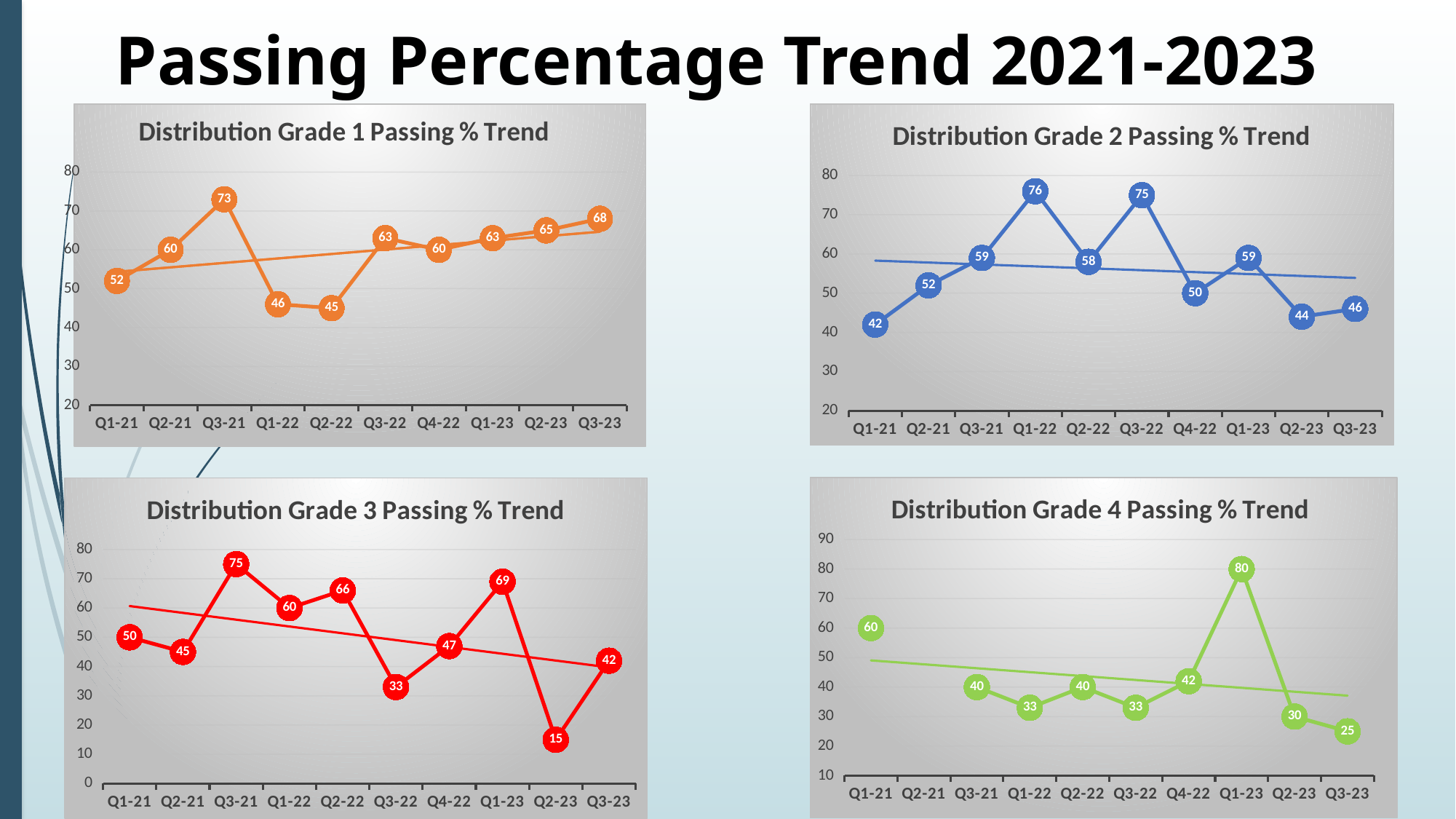
In the Distribution Grade 3 Passing % Trend chart, which is larger, the value for Q2-22 or the value for Q4-22? Q2-22 In the Distribution Grade 2 Passing % Trend chart, what is the difference between the values for Q1-22 and Q3-23? 30 What kind of chart is the Distribution Grade 4 Passing % Trend chart? Line chart In the Distribution Grade 4 Passing % Trend chart, what is the value for Q3-23? 25 In the Distribution Grade 3 Passing % Trend chart, what is the difference between the values for Q3-21 and Q2-23? 60 In the Distribution Grade 4 Passing % Trend chart, what is the value for Q1-23? 80 In the Distribution Grade 1 Passing % Trend chart, do the values rise or fall from Q3-22 to Q3-23? Rise How many charts are shown on the slide? 4 In the Distribution Grade 3 Passing % Trend chart, which quarter has the lowest value? Q2-23 In the Distribution Grade 1 Passing % Trend chart, what is the value for Q3-21? 73 In the Distribution Grade 1 Passing % Trend chart, how many quarters are plotted on the x axis? 10 In the Distribution Grade 2 Passing % Trend chart, which quarter has the highest value? Q1-22